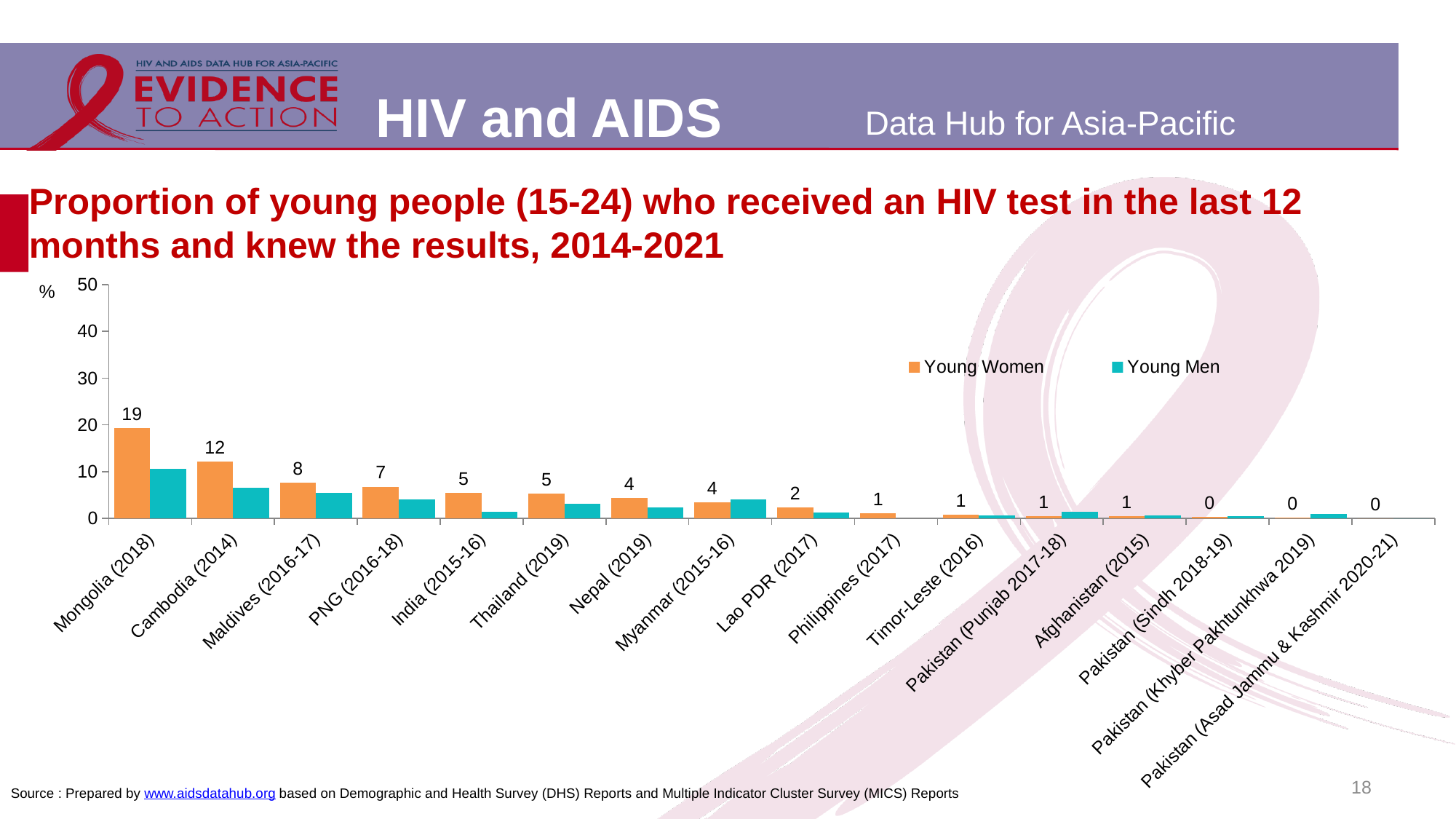
Which country has the highest Young Women value? Mongolia (2018) What is the Young Women value for Lao PDR (2017)? 2 Is the Young Men value for Cambodia (2014) greater or less than 10? less Which is larger, the Young Women value for PNG (2016-18) or for Nepal (2019)? PNG (2016-18) How many countries or regions are shown on the x axis? 16 What type of chart is shown on the slide? bar chart Which series is shown in orange in the legend? Young Women What is the difference between the Young Women values for Mongolia (2018) and Cambodia (2014)? 7 What is the Young Women value for Cambodia (2014)? 12 What is the Young Women value for Mongolia (2018)? 19 What is the Young Women value for Maldives (2016-17)? 8 How many series does the legend list? 2